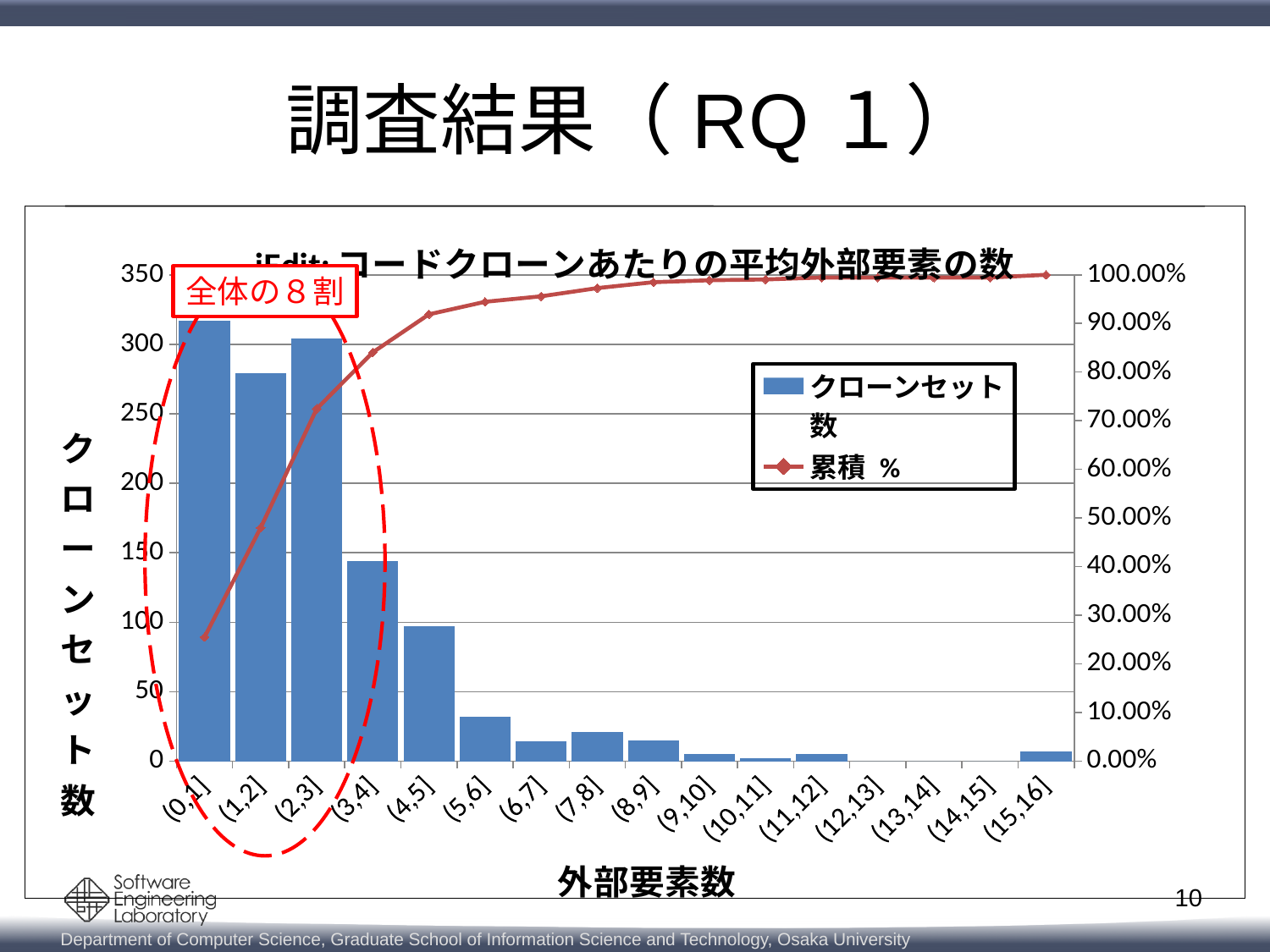
Is the クローンセット数 value for (0,1] greater or less than 300? greater What kind of chart is shown on the slide? A bar chart combined with a line chart Is the クローンセット数 value for (3,4] greater or less than 150? less How many series does the chart's legend list? 2 How many categories are shown on the x axis of the chart? 16 Is the クローンセット数 value for (5,6] greater or less than 50? less What is the title of the x axis of the chart? 外部要素数 Which has the larger クローンセット数 bar, (4,5] or (5,6]? (4,5] Which category has the highest クローンセット数 bar? (0,1] Does the 累積 % line rise or fall from left to right along the x axis? rise Which has the larger クローンセット数 bar, (2,3] or (1,2]? (2,3]